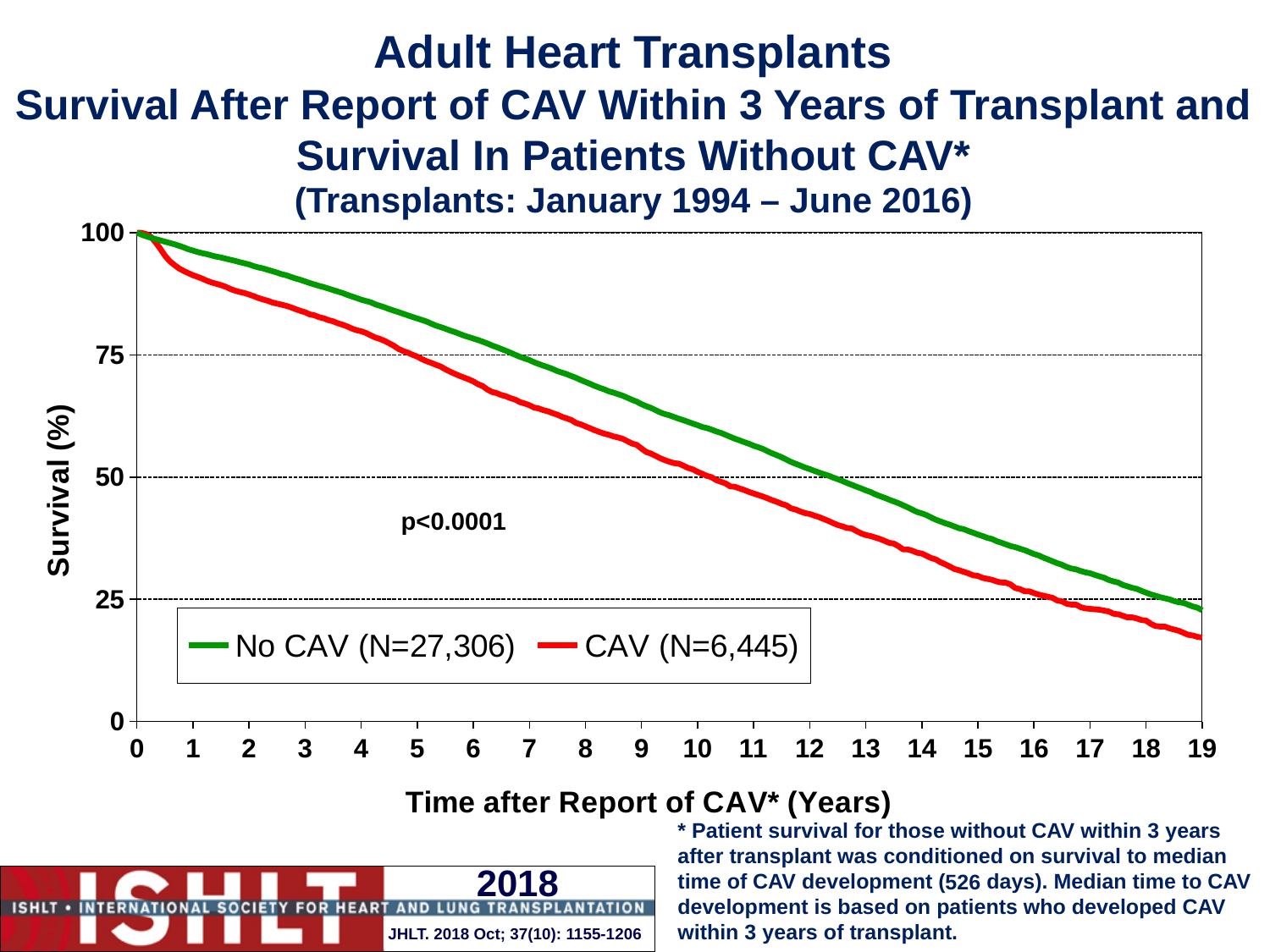
How many series does the legend list? 2 What kind of chart is shown on the slide? Line chart Is the survival value for the CAV group at 3 years greater or less than 75? greater What is the sample size (N) for the No CAV group shown in the legend? 27,306 Do the survival curves rise or fall as time after report of CAV increases? Fall Is the survival value for the CAV group at 15 years greater or less than 25? greater Is the survival value for the No CAV group at 10 years greater or less than 50? greater Which two series are shown in the legend? No CAV (N=27,306) and CAV (N=6,445) At 10 years, which group has higher survival: No CAV or CAV? No CAV Which group has the lower survival curve throughout the follow-up period? CAV